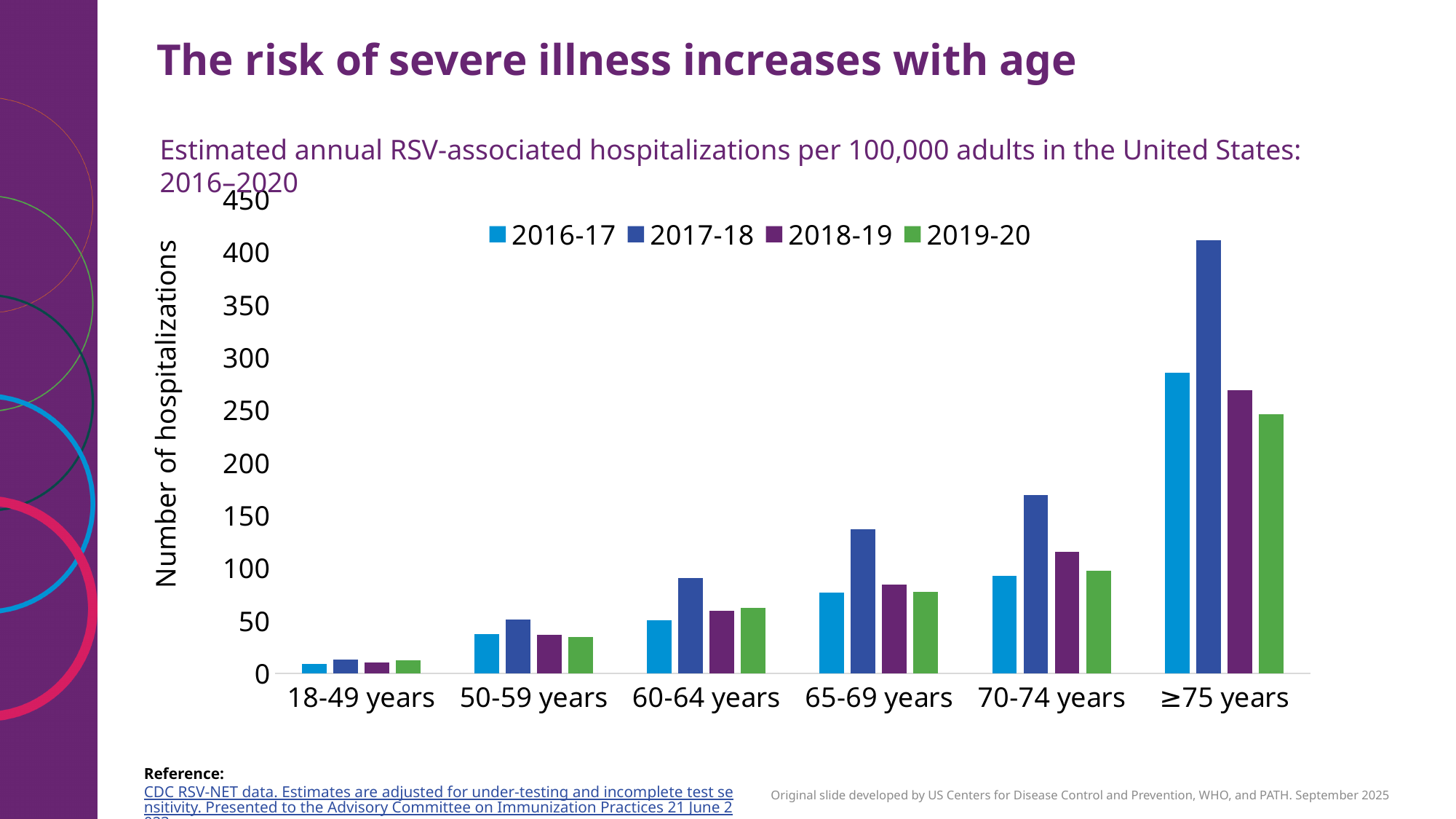
For the 65-69 years group, which series has the larger value: 2016-17 or 2017-18? 2017-18 Is the 2016-17 value for ≥75 years greater or less than 250? greater What is the title of the y axis? Number of hospitalizations Is the 2017-18 value for ≥75 years greater or less than 350? greater Which age group has the highest value for the 2017-18 series? ≥75 years Is the 2018-19 value for 60-64 years greater or less than 100? less Which age group has the lowest value for the 2017-18 series? 18-49 years How many age groups are shown on the x axis? 6 What kind of chart is shown on the slide? bar chart How many series does the legend list? 4 Do the hospitalization values generally rise or fall as age increases along the x axis? rise